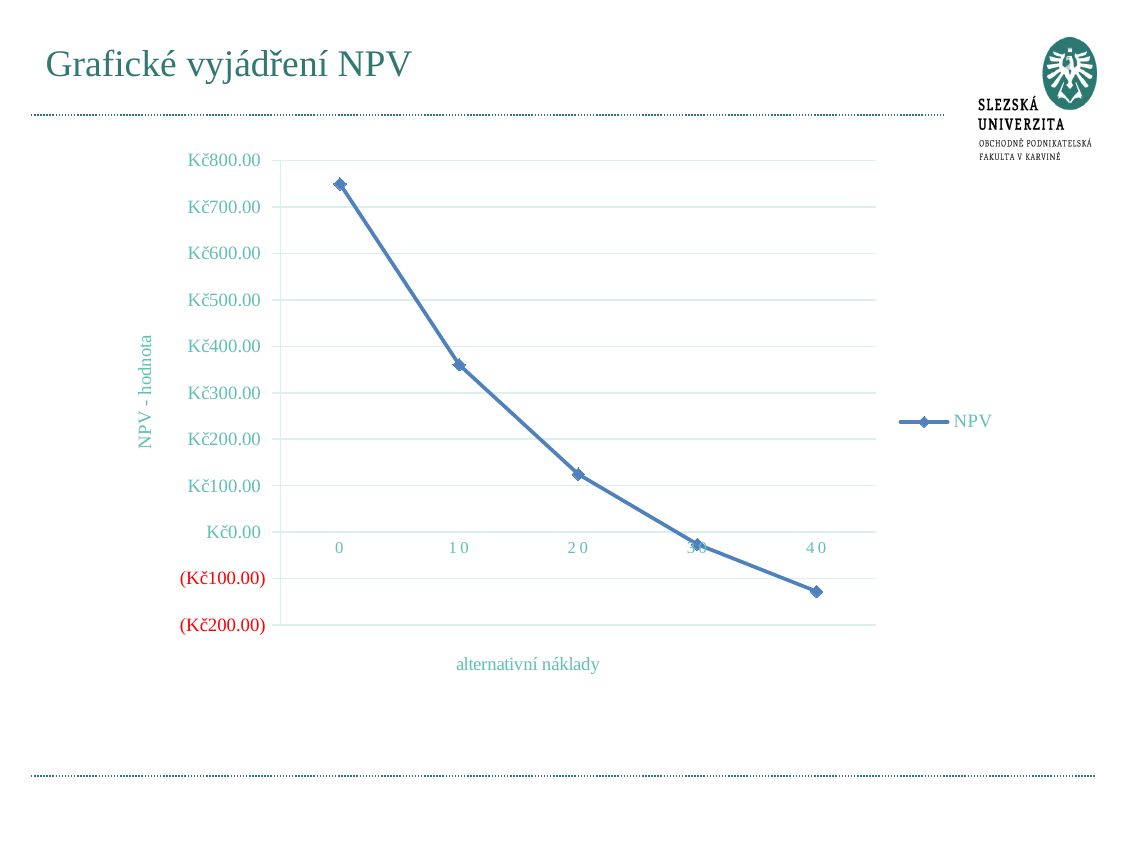
At which value of alternativní náklady is NPV lowest? 40 How many series does the legend list? 1 Do the NPV values rise or fall as alternativní náklady increases along the x axis? fall At which value of alternativní náklady is NPV highest? 0 Is the NPV value at alternativní náklady 10 greater or less than Kč400.00? less Which is larger, the NPV value at alternativní náklady 10 or at 20? 10 Is the NPV value at alternativní náklady 0 greater or less than Kč700.00? greater What is the title of the x axis of the chart? alternativní náklady What is the name of the series shown in the legend? NPV Is the NPV value at alternativní náklady 40 greater or less than Kč0.00? less How many data points are plotted on the NPV line? 5 What kind of chart is shown on the slide? line chart